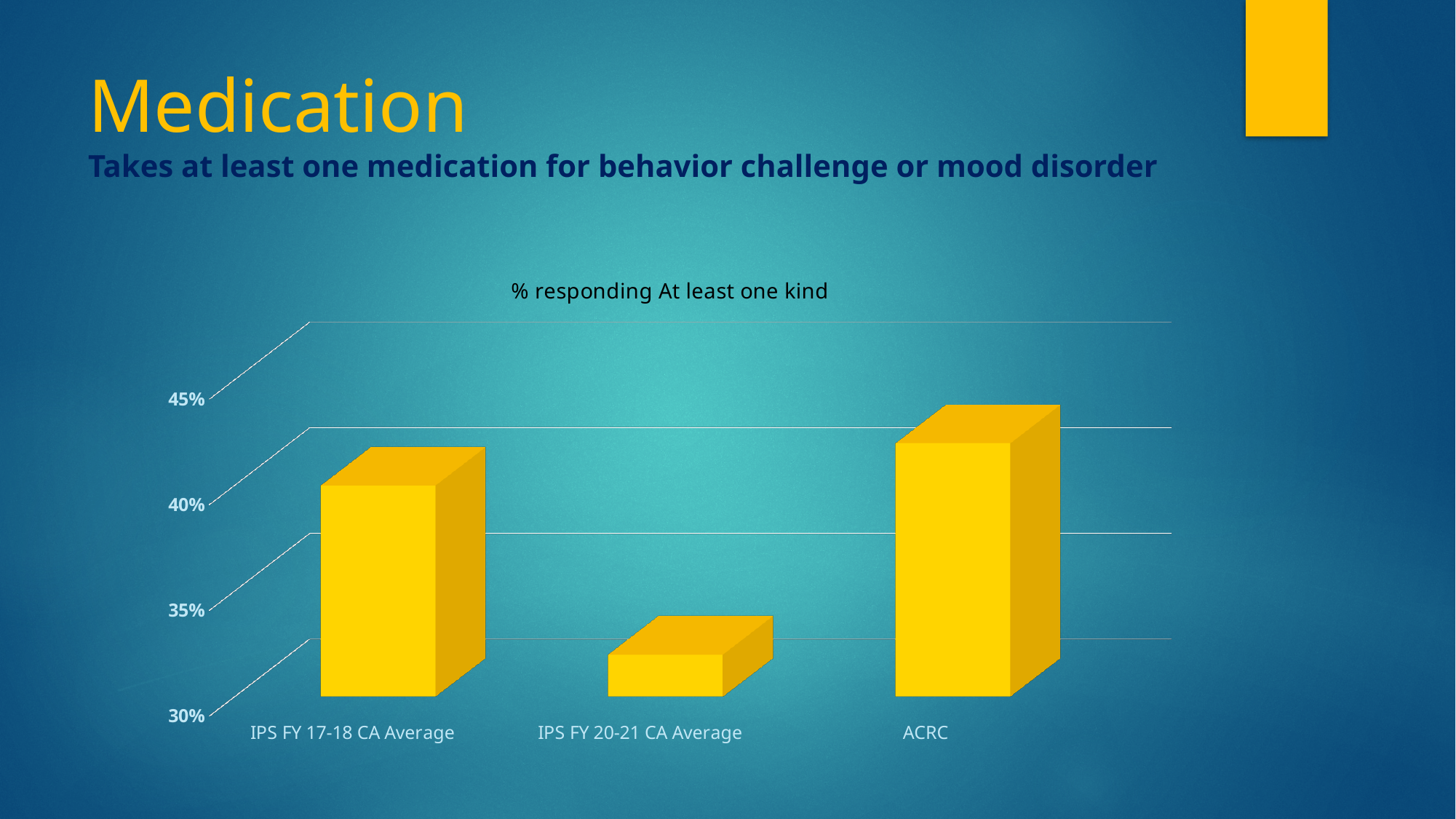
Which category has the highest value? ACRC What is the title of the chart? % responding At least one kind Which category has the lowest value? IPS FY 20-21 CA Average What is the lowest value shown on the vertical axis? 30% Is the value for ACRC greater or less than 40%? greater What kind of chart is shown on the slide? bar chart Which is larger, the value for ACRC or the value for IPS FY 17-18 CA Average? ACRC Is the value for ACRC greater or less than 45%? less Is the value for IPS FY 20-21 CA Average greater or less than 35%? less Which is larger, the value for IPS FY 17-18 CA Average or the value for IPS FY 20-21 CA Average? IPS FY 17-18 CA Average How many categories are plotted in the chart? 3